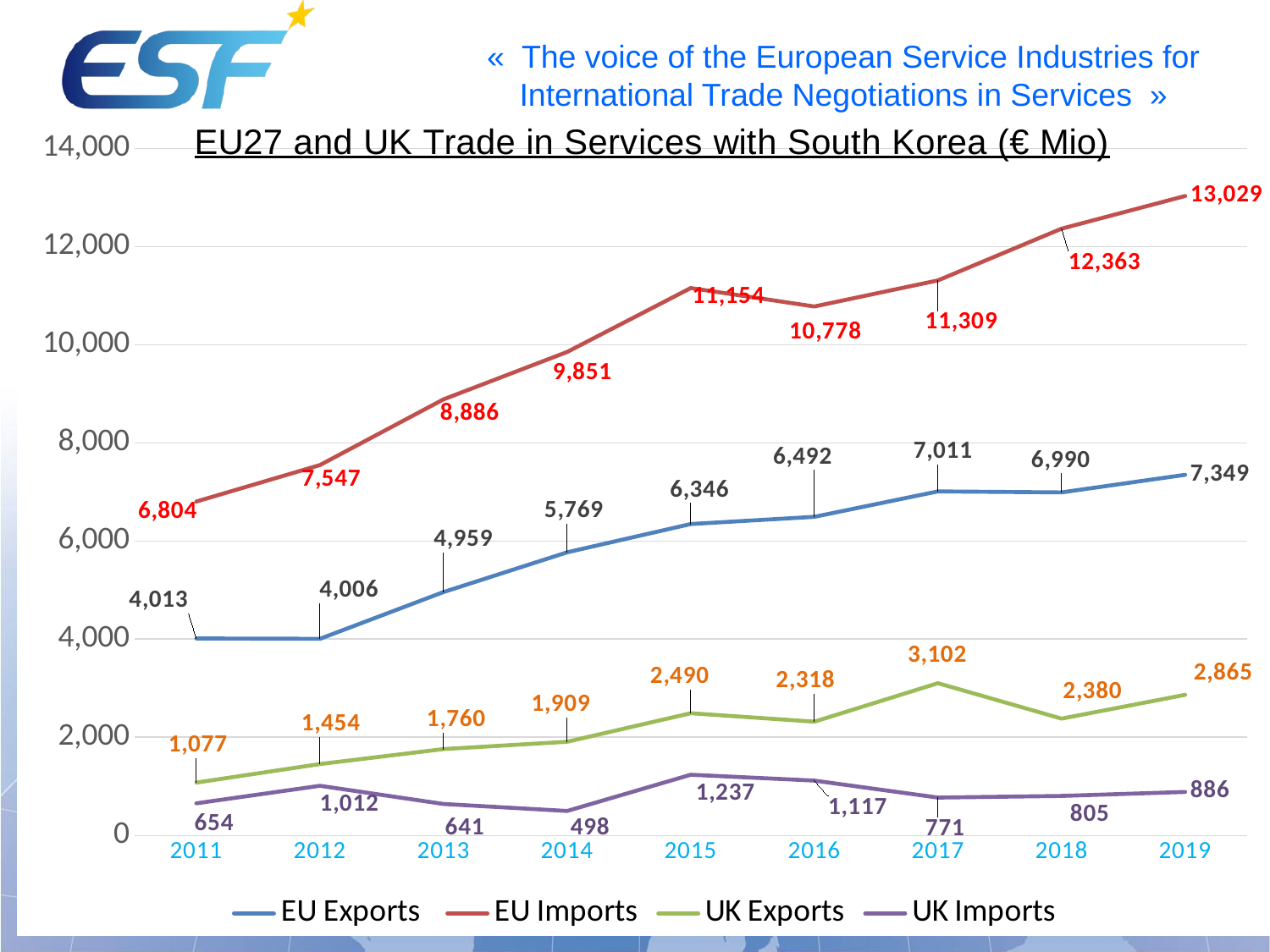
What is the difference between EU Imports and EU Exports in 2019? 5,680 What kind of chart is shown on the slide? Line chart How many series does the legend list? 4 In which year is UK Imports at its lowest? 2014 How many years are shown on the x axis? 9 What is the value of EU Imports in 2019? 13,029 What is the value of UK Exports in 2017? 3,102 Does EU Imports generally rise or fall from 2011 to 2019? Rise What is the value of UK Imports in 2014? 498 What is the value of EU Exports in 2014? 5,769 Which is larger in 2016: UK Exports or UK Imports? UK Exports In which year is UK Exports at its highest? 2017